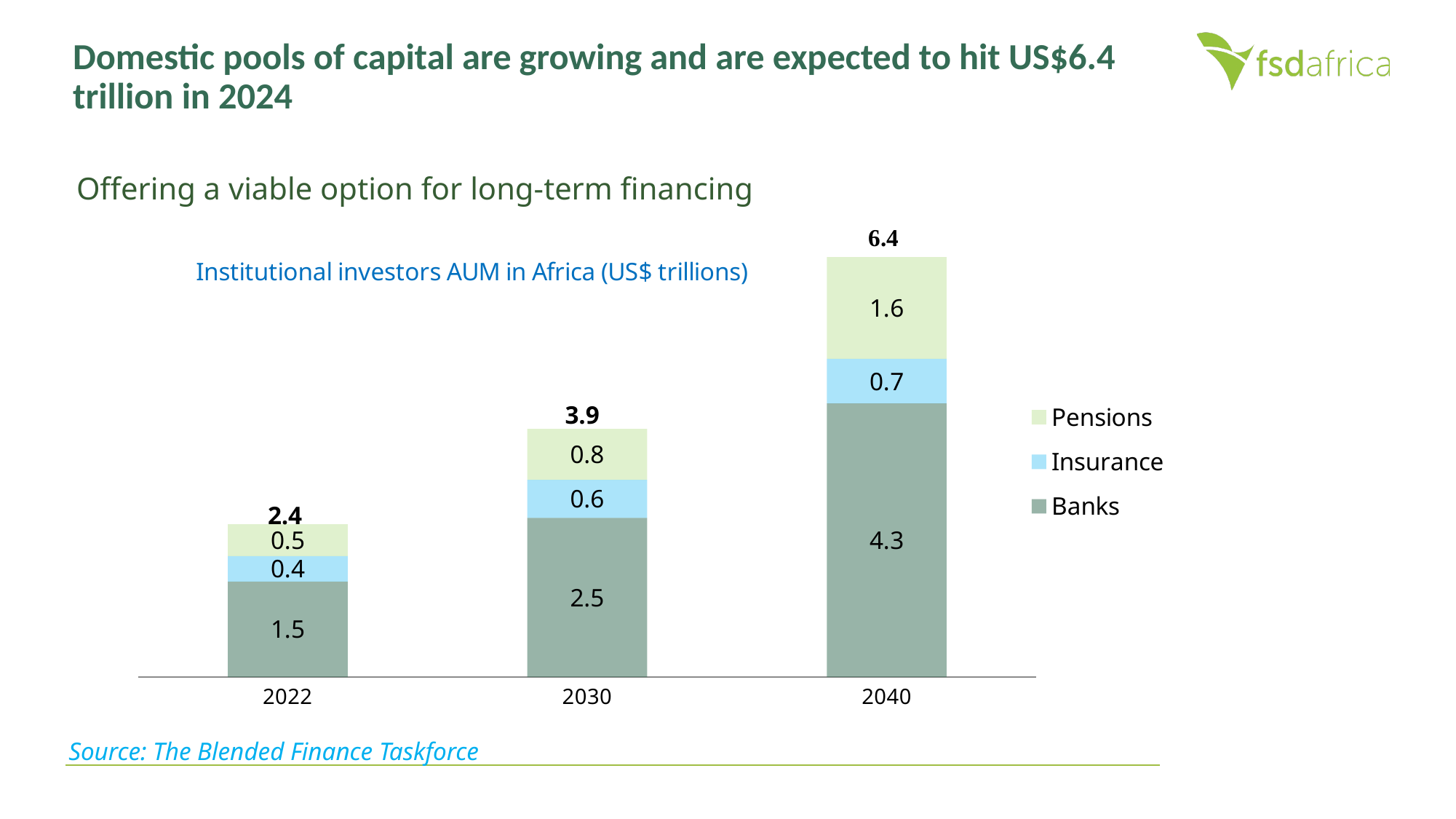
Which year has the lowest value for Banks? 2022 What is the value for Pensions in 2022? 0.5 What is the difference between the Banks value in 2040 and the Banks value in 2022? 2.8 How many years are shown on the x axis? 3 What kind of chart is shown on the slide? Stacked bar chart What is the total of the stacked bar for 2030? 3.9 What is the total of the stacked bar for 2022? 2.4 Which year has the highest total AUM? 2040 What is the value for Insurance in 2030? 0.6 Which is larger, Pensions in 2030 or Insurance in 2030? Pensions in 2030 How many series does the legend list? 3 What is the value for Banks in 2040? 4.3